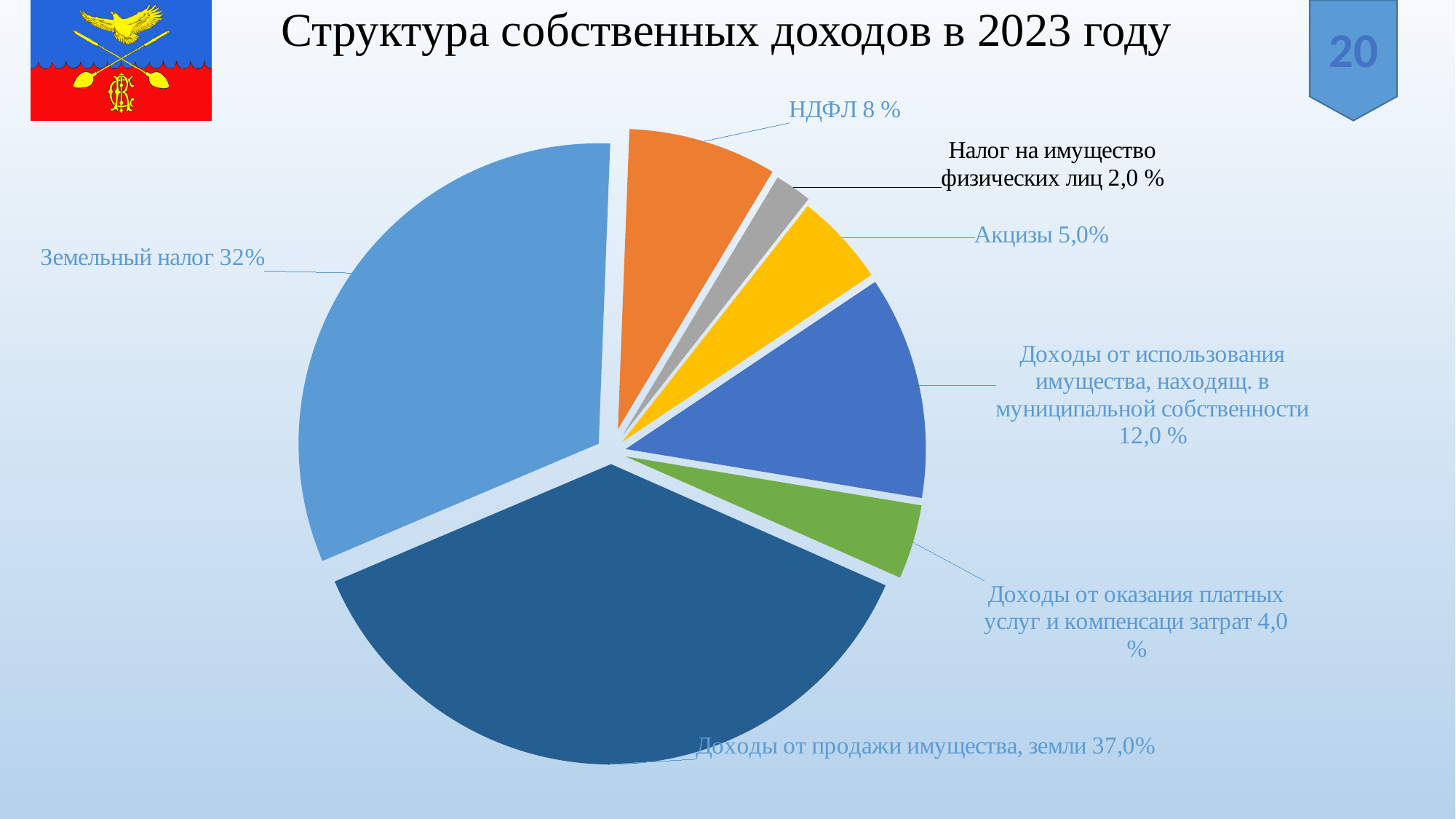
What kind of chart is shown on the slide? Pie chart What share is shown for НДФЛ? 8 % What is the difference in percentage points between Доходы от продажи имущества, земли and Земельный налог? 5 How many slices does the pie chart have? 7 Which category has the smallest slice of the pie? Налог на имущество физических лиц What share is shown for Акцизы? 5,0% What share is shown for Доходы от продажи имущества, земли? 37,0% What is the title of the chart? Структура собственных доходов в 2023 году Which is larger: the share for Доходы от использования имущества, находящ. в муниципальной собственности or the share for НДФЛ? Доходы от использования имущества, находящ. в муниципальной собственности Which category has the largest slice of the pie? Доходы от продажи имущества, земли